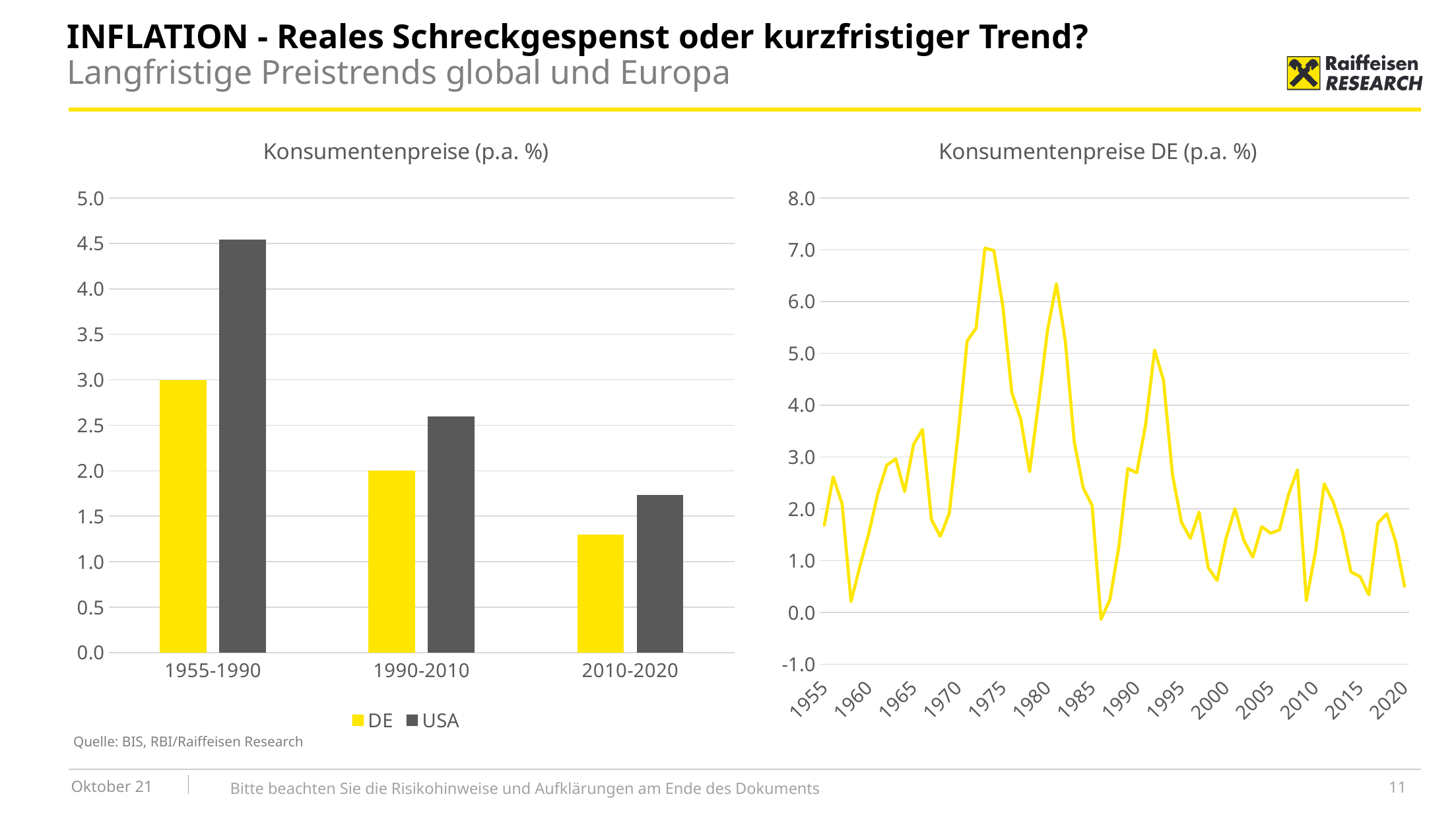
In the chart titled "Konsumentenpreise (p.a. %)", which period has the highest value for USA? 1955-1990 In the chart titled "Konsumentenpreise (p.a. %)", how many periods are shown on the x axis? 3 In the chart titled "Konsumentenpreise (p.a. %)", what is the value for DE in 1990-2010? 2.0 In the chart titled "Konsumentenpreise DE (p.a. %)", what kind of chart is shown? line chart In the chart titled "Konsumentenpreise (p.a. %)", which period has the lowest value for DE? 2010-2020 In the chart titled "Konsumentenpreise (p.a. %)", which is larger in 2010-2020, DE or USA? USA In the chart titled "Konsumentenpreise (p.a. %)", do the DE values rise or fall across the periods from left to right? fall In the chart titled "Konsumentenpreise (p.a. %)", which colour represents the USA series? dark grey In the chart titled "Konsumentenpreise (p.a. %)", what is the value for DE in 1955-1990? 3.0 In the chart titled "Konsumentenpreise (p.a. %)", is the value for USA in 1955-1990 greater or less than 4.0? greater In the chart titled "Konsumentenpreise (p.a. %)", how many series does the legend list? 2 In the chart titled "Konsumentenpreise (p.a. %)", what kind of chart is shown? bar chart